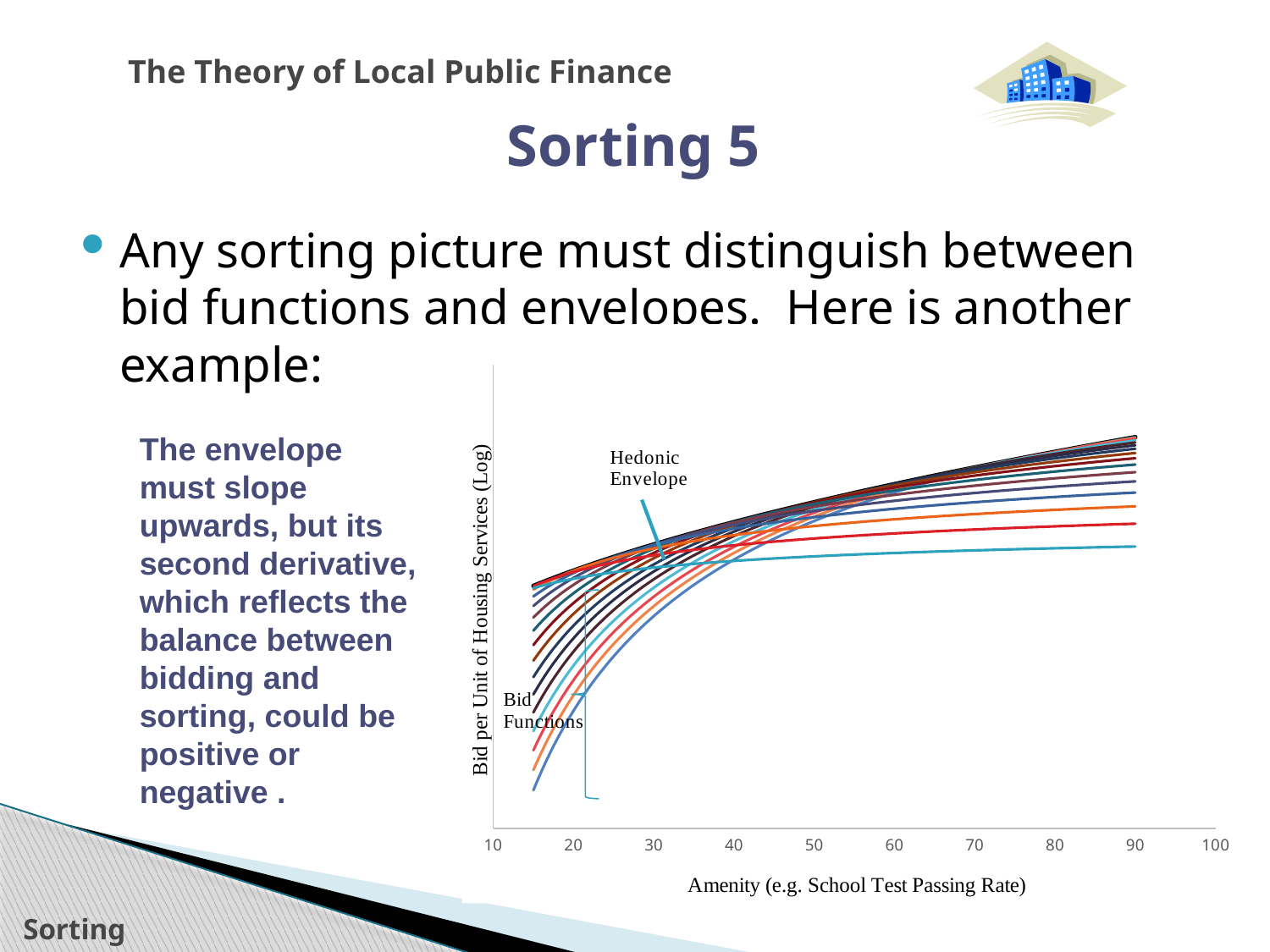
Which labelled curve lies above all the bid functions across the chart? Hedonic Envelope What is the title of the x axis of the chart? Amenity (e.g. School Test Passing Rate) What is the title of the y axis of the chart? Bid per Unit of Housing Services (Log) What kind of chart is shown on the slide? line chart Do the plotted curves rise or fall as the amenity value increases along the x axis? rise